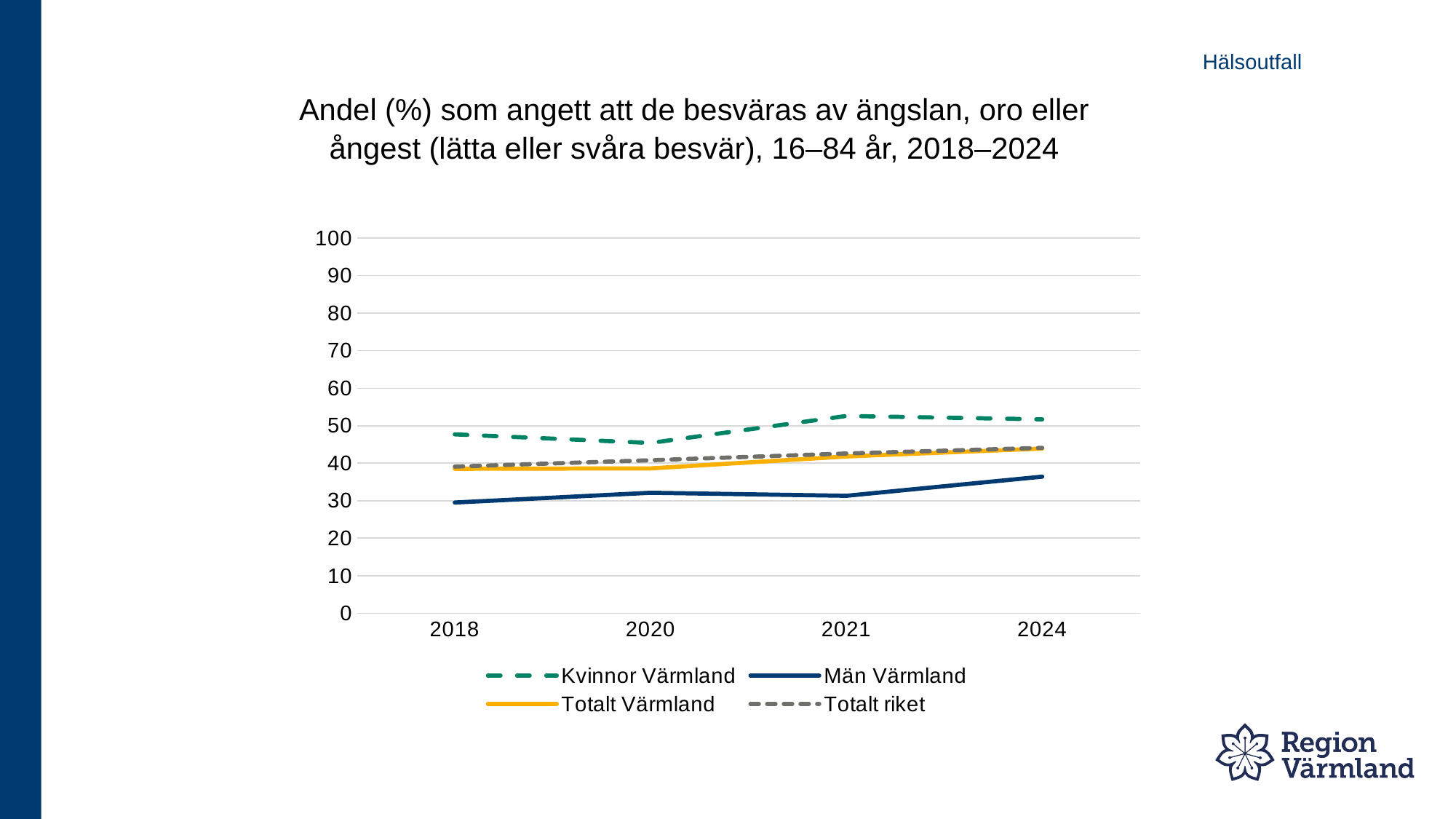
Is the value for Män Värmland in 2024 greater or less than 30? greater What kind of chart is shown on the slide? Line chart Which series is drawn with a solid yellow line? Totalt Värmland Which series has the lowest value in 2018? Män Värmland Which series has the highest value in 2021? Kvinnor Värmland Is the value for Kvinnor Värmland in 2021 greater or less than 50? greater Does the value for Män Värmland rise or fall from 2018 to 2024? rise Is the value for Totalt riket in 2024 greater or less than 40? greater How many years are shown on the x axis? 4 In 2024, which is larger: Kvinnor Värmland or Män Värmland? Kvinnor Värmland How many series does the legend list? 4